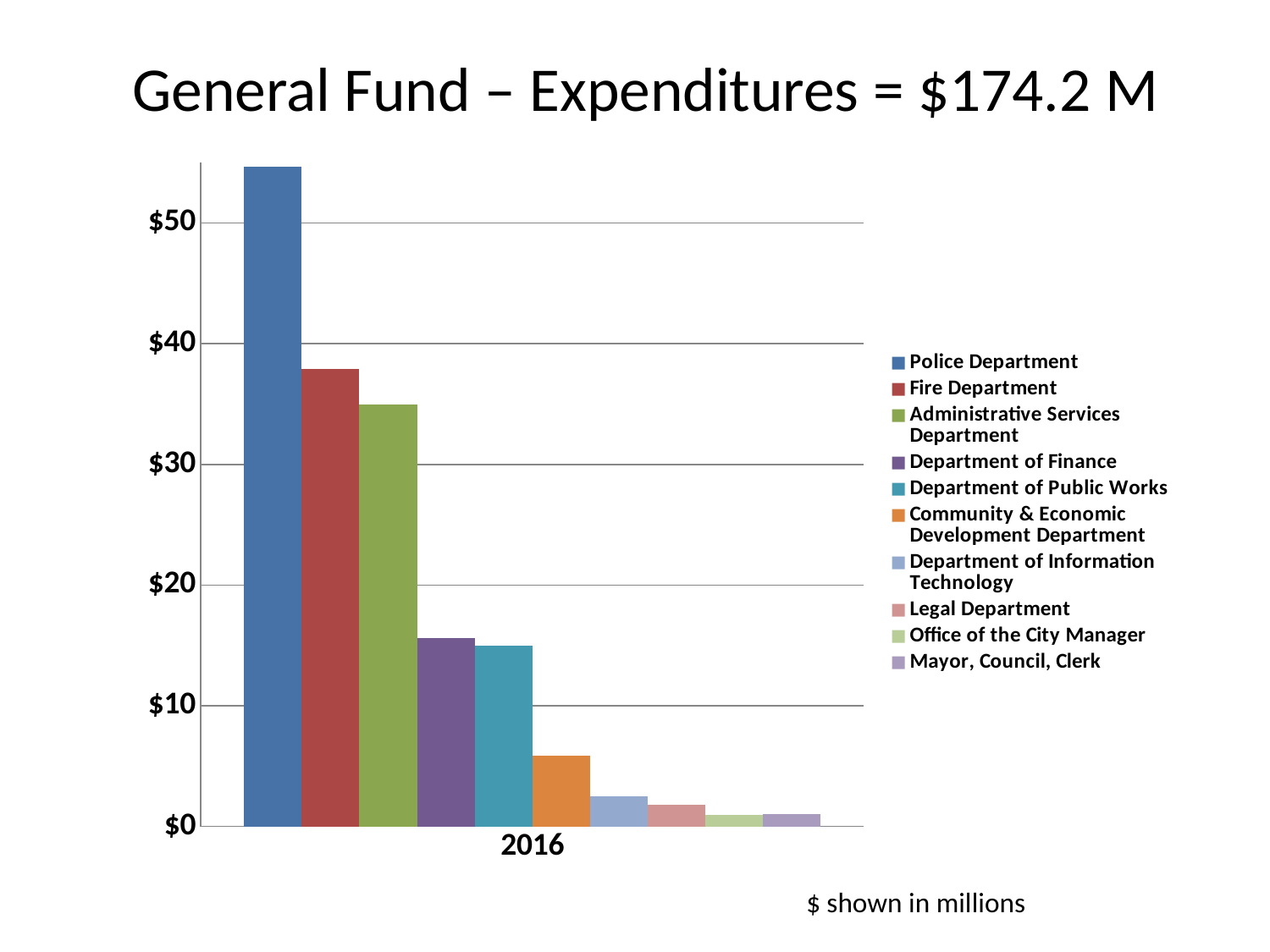
Is the value for the Fire Department greater or less than $40? less Is the value for the Administrative Services Department greater or less than $30? greater What kind of chart is shown on the slide? bar chart What is the title of the slide? General Fund – Expenditures = $174.2 M How many series does the legend list? 10 Is the value for the Police Department greater or less than $50? greater Which is larger, the value for the Police Department or the Fire Department? Police Department Which department has the highest expenditure in the chart? Police Department What year is labelled on the x axis of the chart? 2016